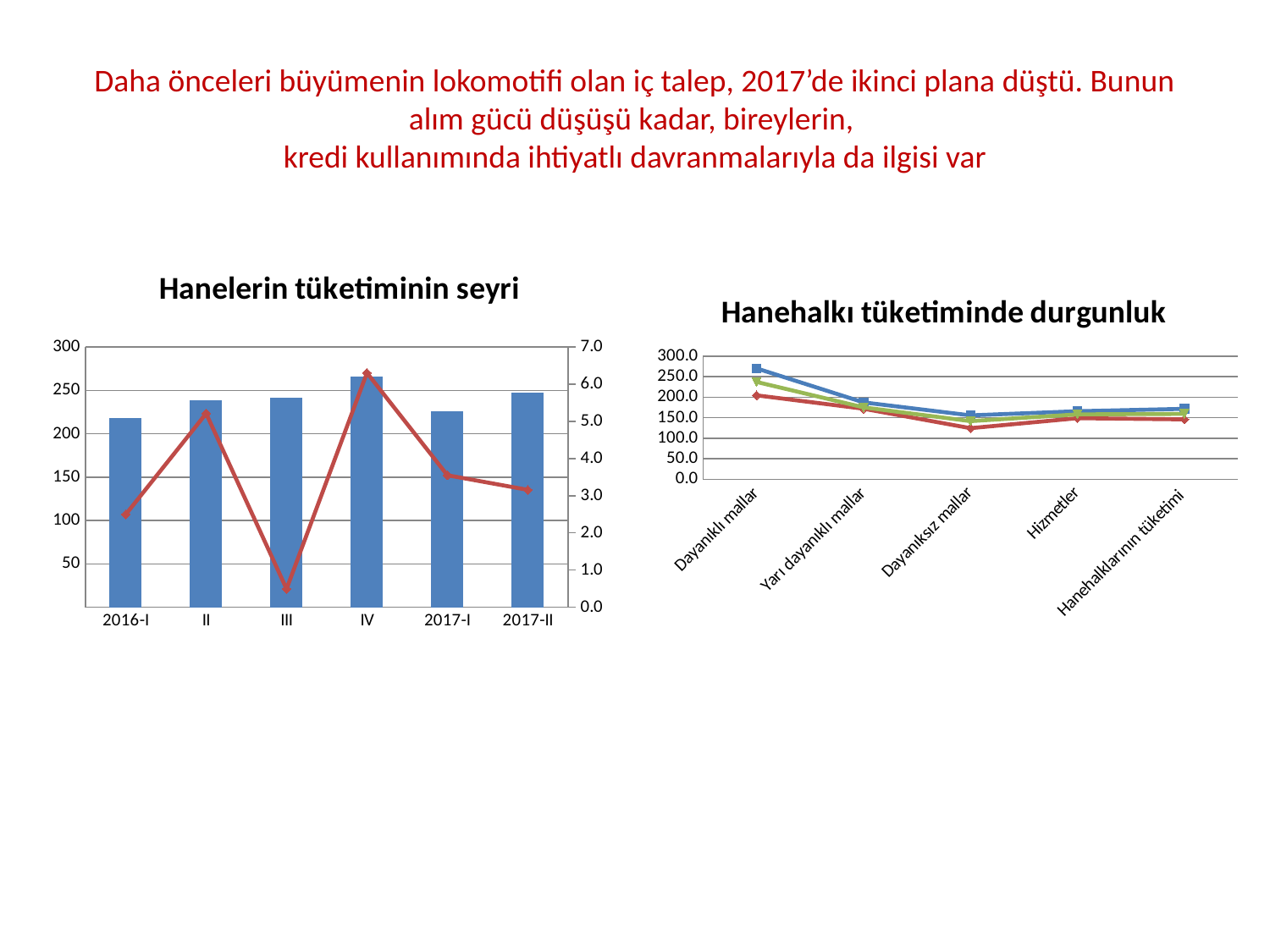
In the 'Hanelerin tüketiminin seyri' chart on the left, is the bar for IV greater or less than 250 on the left axis? greater In the 'Hanelerin tüketiminin seyri' chart on the left, at which category does the red line reach its lowest point? III In the 'Hanehalkı tüketiminde durgunluk' chart on the right, is the blue line's value for Dayanıklı mallar greater or less than 250.0? greater In the 'Hanehalkı tüketiminde durgunluk' chart on the right, do the lines rise or fall from Dayanıklı mallar to Dayanıksız mallar? fall In the 'Hanelerin tüketiminin seyri' chart on the left, how many categories are shown on the x axis? 6 What kind of chart is the 'Hanehalkı tüketiminde durgunluk' chart on the right? line chart How many lines are plotted in the 'Hanehalkı tüketiminde durgunluk' chart on the right? 3 In the 'Hanehalkı tüketiminde durgunluk' chart on the right, how many categories are shown on the x axis? 5 In the 'Hanelerin tüketiminin seyri' chart on the left, which category has the shortest bar? 2016-I In the 'Hanelerin tüketiminin seyri' chart on the left, which category has the tallest bar? IV In the 'Hanelerin tüketiminin seyri' chart on the left, which bar is taller, IV or 2017-I? IV In the 'Hanelerin tüketiminin seyri' chart on the left, is the bar for 2017-I greater or less than 250 on the left axis? less